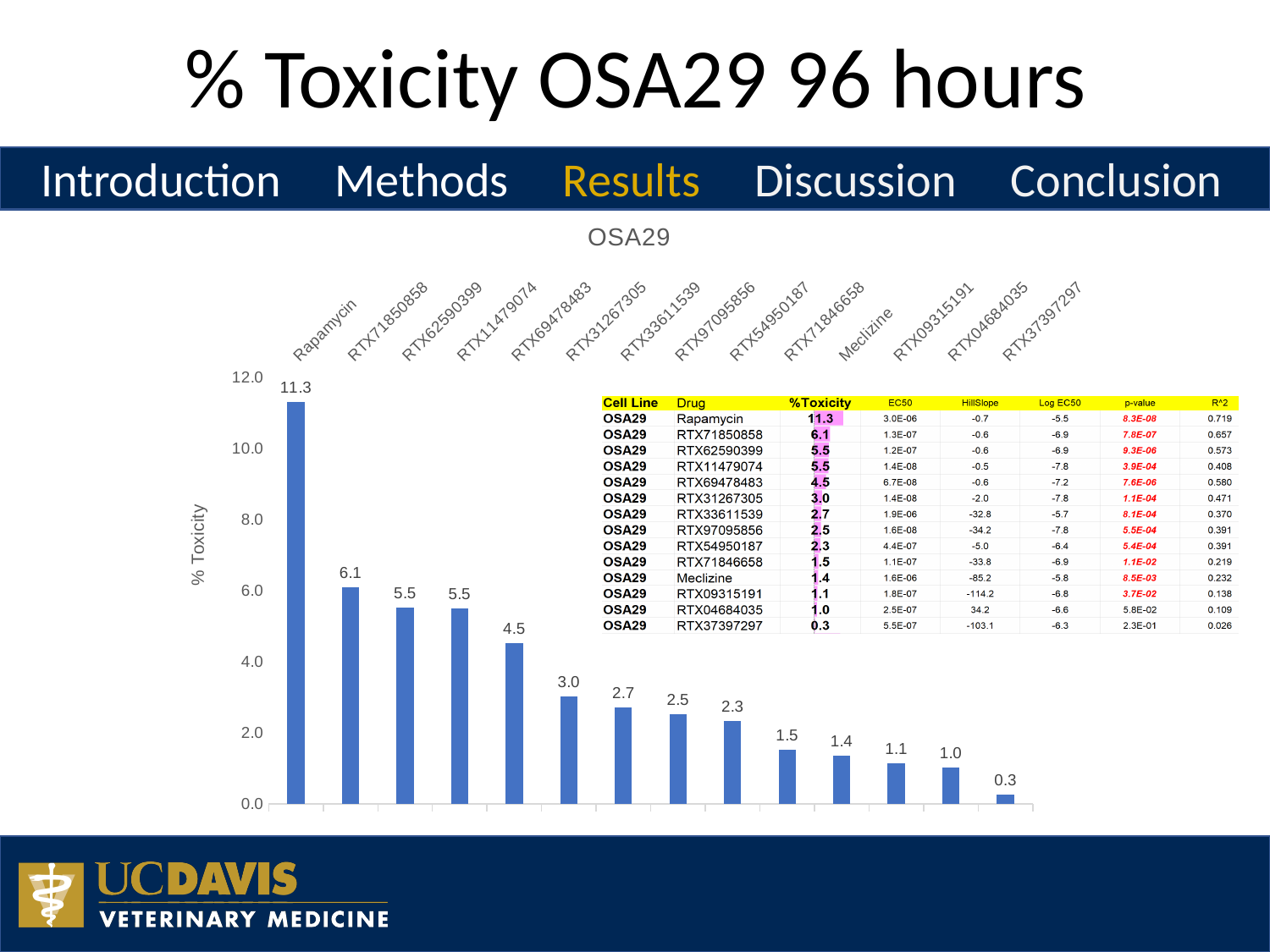
Which drug has the lowest % Toxicity in the chart? RTX37397297 What is the % Toxicity value for Meclizine? 1.4 Do the % Toxicity values rise or fall from left to right across the chart? Fall Which has a higher % Toxicity, RTX31267305 or RTX97095856? RTX31267305 Which drug has the highest % Toxicity in the chart? Rapamycin What is the label on the vertical axis of the chart? % Toxicity What is the % Toxicity value for RTX69478483? 4.5 What is the title of the chart? OSA29 What is the difference in % Toxicity between Rapamycin and RTX71850858? 5.2 What is the % Toxicity value for Rapamycin? 11.3 How many drugs (bars) are shown in the chart? 14 What type of chart is shown on the slide? Bar chart